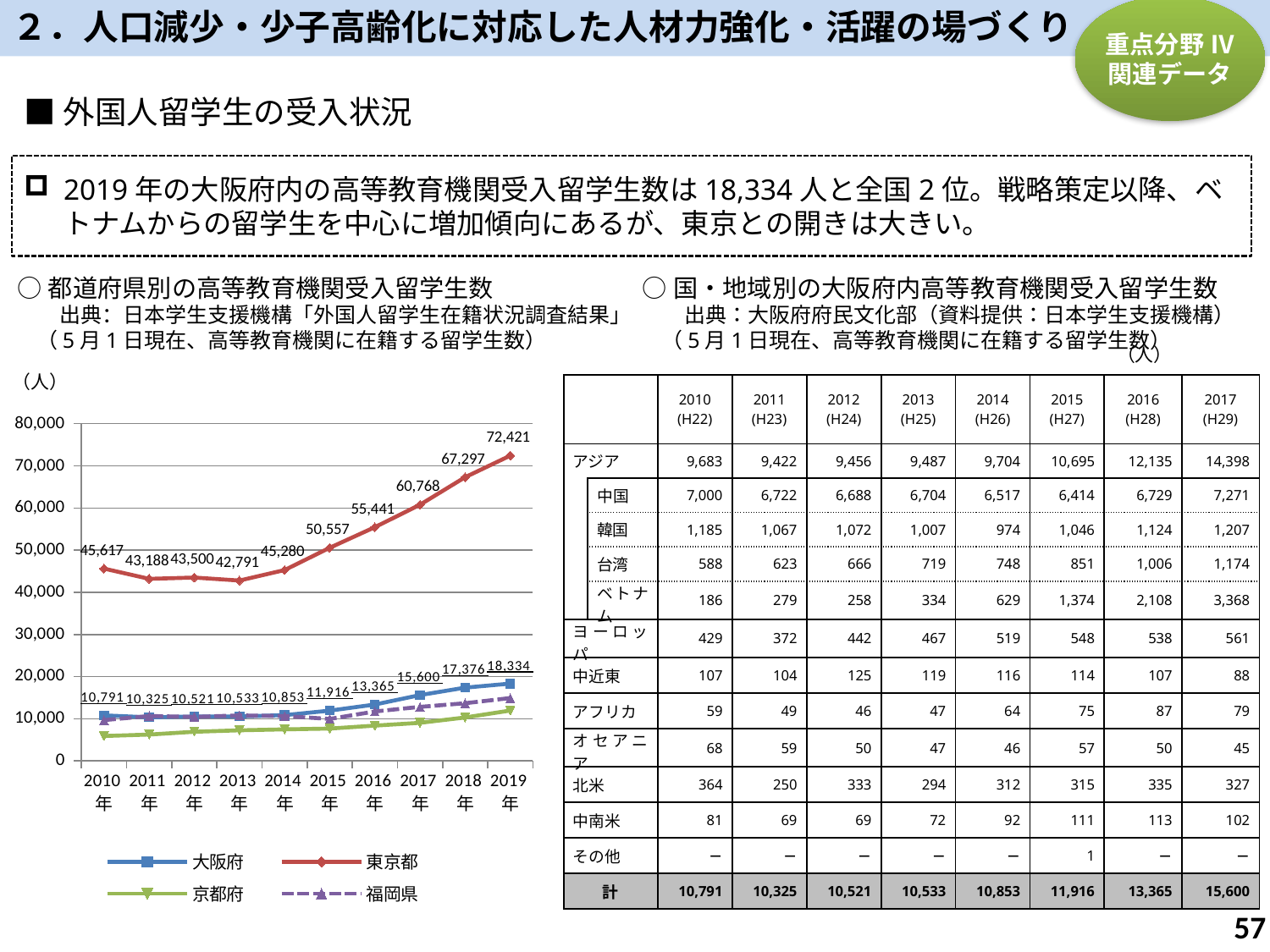
In the line chart, what is the value for 東京都 in 2013年? 42,791 How many series does the legend of the line chart list? 4 In the line chart, which is larger: the value for 大阪府 in 2019年 or the value for 福岡県 in 2019年? 大阪府 How many years are plotted on the x axis of the line chart? 10 What kind of chart is shown on the left of the slide? line chart In the line chart, is the value for 京都府 in 2019年 greater or less than 20,000? less In the line chart, what is the difference between 東京都 and 大阪府 in 2019年? 54,087 In the line chart, what is the value for 大阪府 in 2019年? 18,334 In the line chart, which series has the lowest value in 2010年? 京都府 In the line chart, which series has the highest value in 2019年? 東京都 In the line chart, what is the value for 東京都 in 2019年? 72,421 In the line chart, what is the value for 大阪府 in 2015年? 11,916